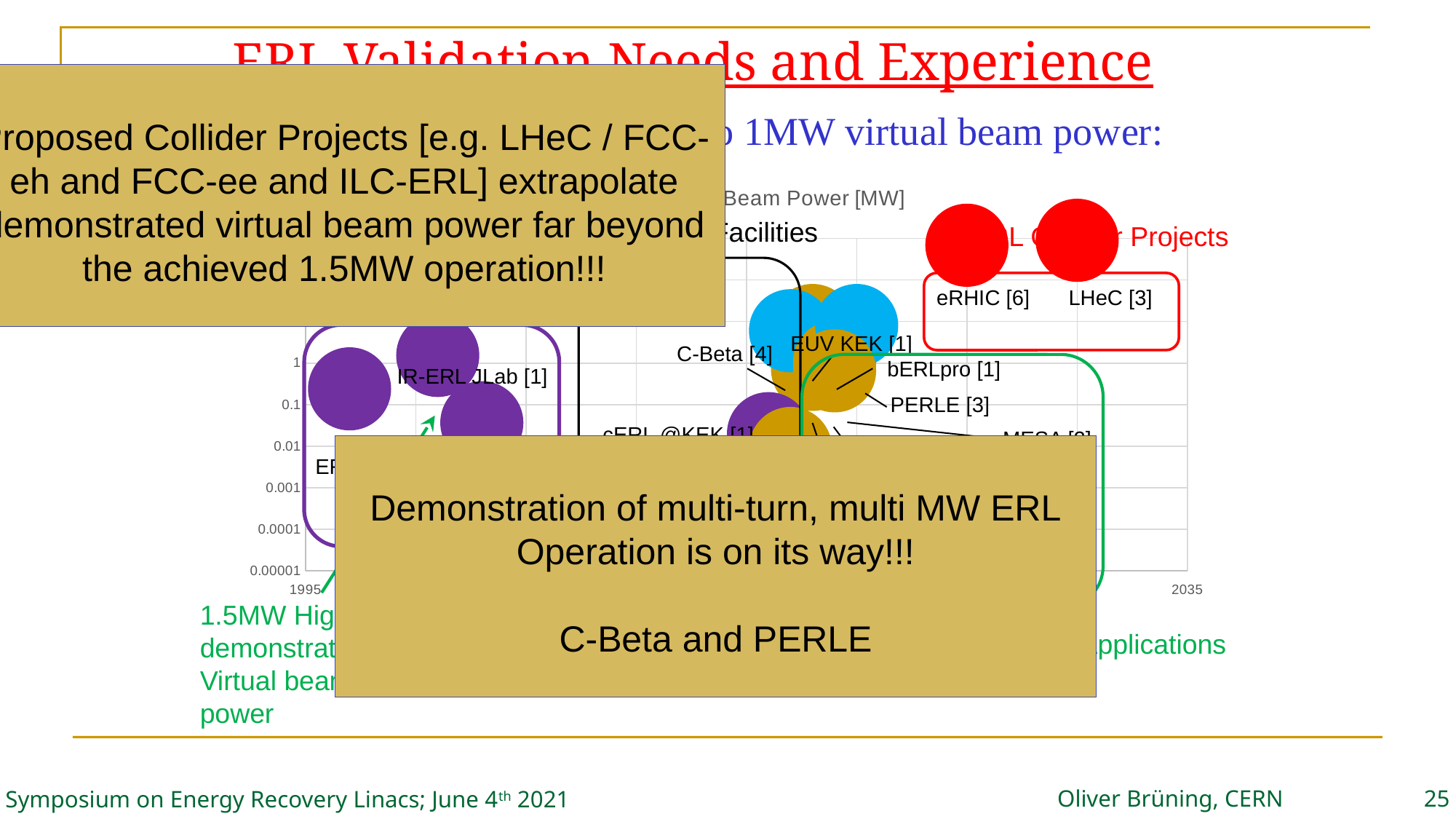
Is the virtual beam power for LHeC greater or less than 1 MW? greater Do the plotted virtual beam power values generally rise or fall as the year increases along the x axis? rise What is the latest year shown on the x axis of the chart? 2035 What is the earliest year shown on the x axis of the chart? 1995 What is the lowest tick value shown on the y axis of the chart? 0.00001 What kind of chart is shown on the slide? bubble (scatter) chart Which has the higher virtual beam power, eRHIC or cERL @KEK? eRHIC Which two projects are enclosed in the red 'Collider Projects' box on the chart? eRHIC [6] and LHeC [3] Is the virtual beam power for eRHIC greater or less than 1 MW? greater Which has the higher virtual beam power, LHeC or IR-ERL JLab? LHeC